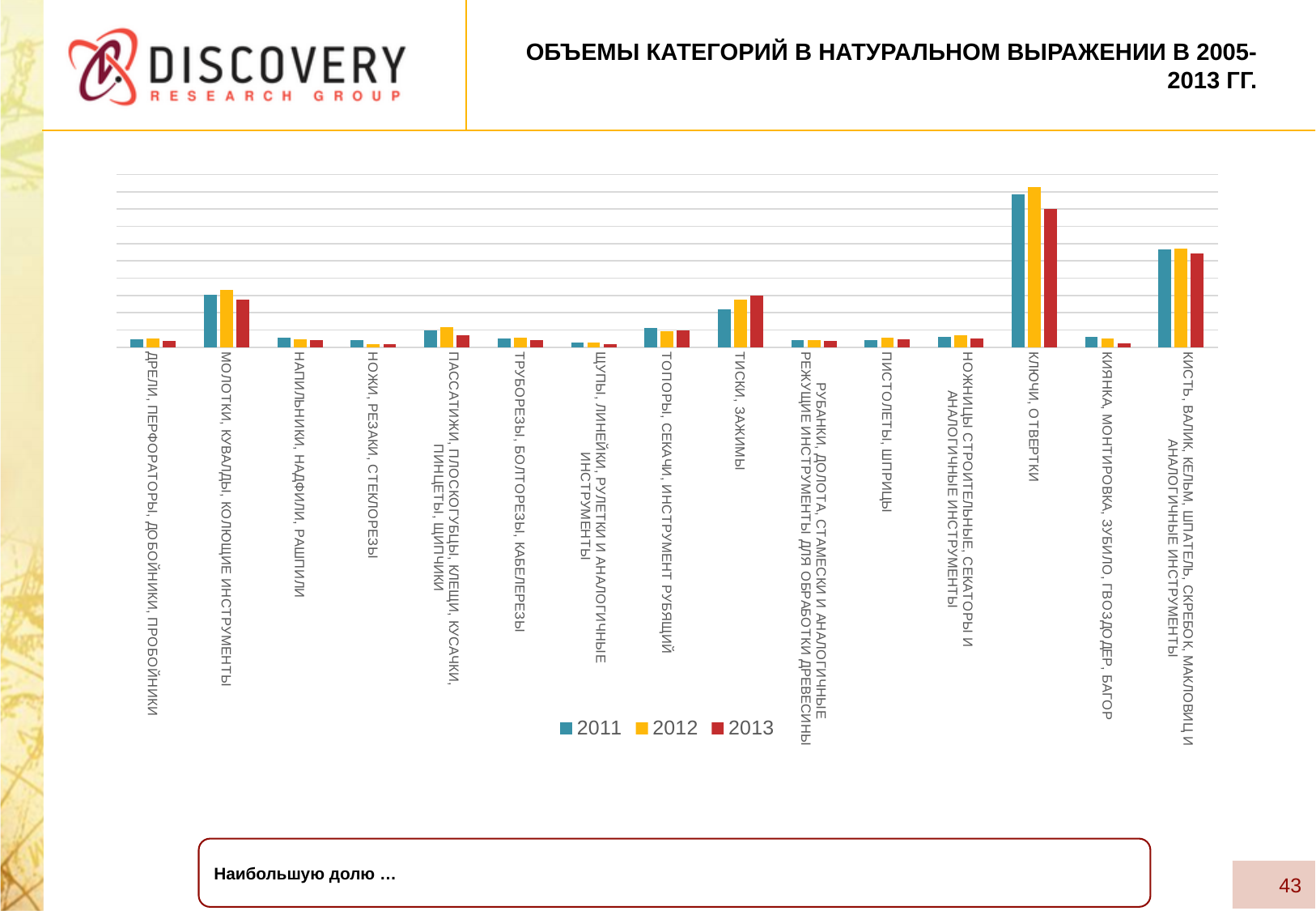
Which category has the highest bars in the chart? Ключи, отвертки For Ключи, отвертки, which year has the shortest bar? 2013 What colour represents the 2013 series in the chart? red For Ключи, отвертки, which year has the tallest bar? 2012 How many series does the legend list? 3 For Тиски, зажимы, do the values rise or fall from 2011 to 2013? rise Which years are listed in the legend? 2011, 2012, 2013 What kind of chart is shown on the slide? bar chart Which category has the second-highest bars in the chart? Кисть, валик, кельм, шпатель, скребок, макловиц и аналогичные инструменты Which is larger in 2013: Ключи, отвертки or Молотки, кувалды, колющие инструменты? Ключи, отвертки How many product categories are shown on the x axis? 15 Which is larger in 2012: Тиски, зажимы or Топоры, секачи, инструмент рубящий? Тиски, зажимы